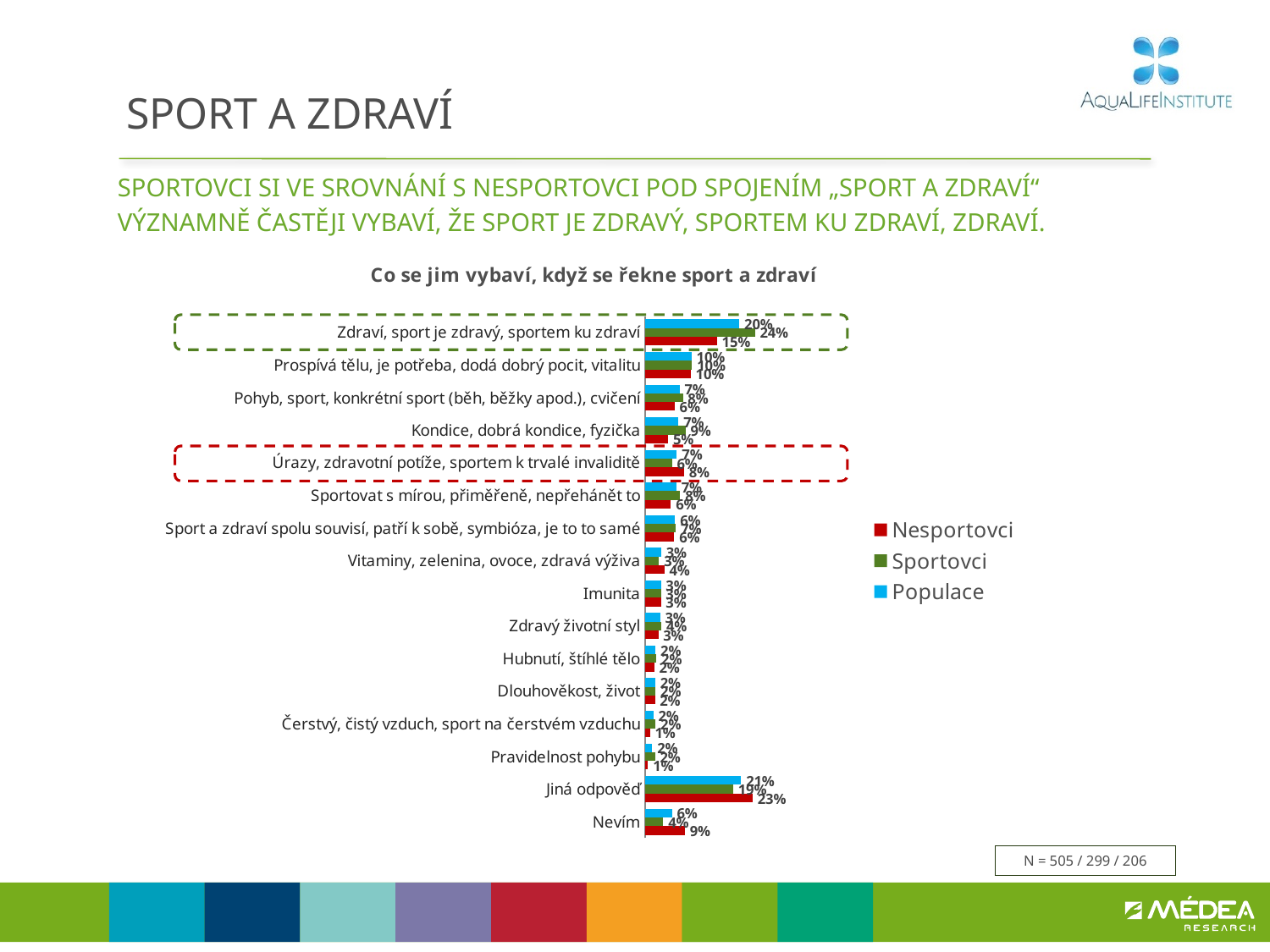
Which colour represents the Populace series in the chart? blue What is the difference between Sportovci and Nesportovci in the category "Zdraví, sport je zdravý, sportem ku zdraví"? 9 percentage points How many series does the legend list? 3 What is the value for Nesportovci in the category "Nevím"? 9% What is the value for Sportovci in the category "Zdraví, sport je zdravý, sportem ku zdraví"? 24% In the category "Kondice, dobrá kondice, fyzička", which is larger: Sportovci or Nesportovci? Sportovci In the category "Úrazy, zdravotní potíže, sportem k trvalé invaliditě", which is larger: Nesportovci or Sportovci? Nesportovci What kind of chart is shown on the slide? bar chart What is the value for Nesportovci in the category "Zdraví, sport je zdravý, sportem ku zdraví"? 15% What is the title of the chart? Co se jim vybaví, když se řekne sport a zdraví What is the value for Populace in the category "Jiná odpověď"? 21% How many categories are plotted in the chart? 16